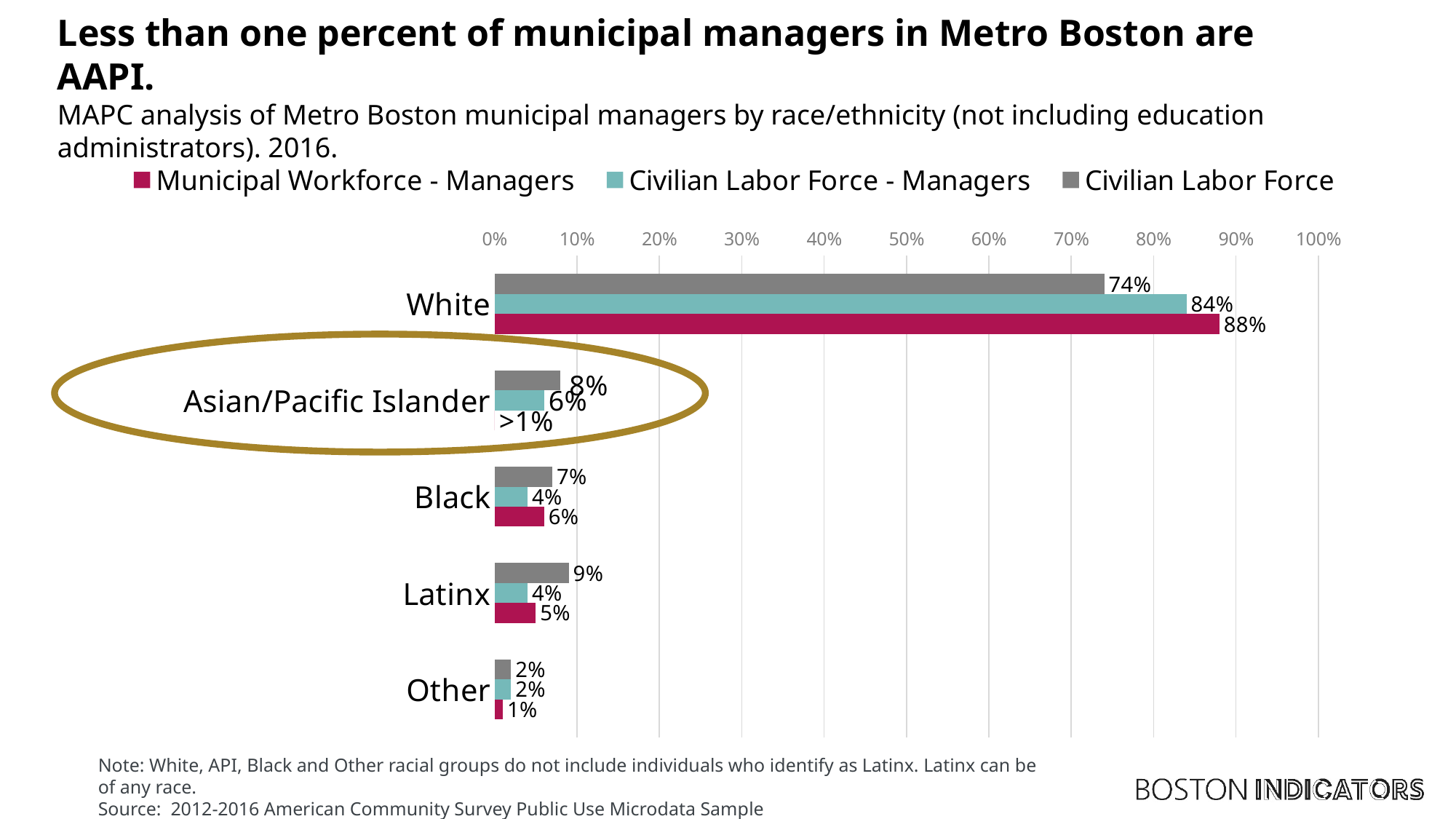
What is the Municipal Workforce - Managers value for White? 88% Which category is circled on the chart? Asian/Pacific Islander What is the Civilian Labor Force - Managers value for Asian/Pacific Islander? 6% How many race/ethnicity categories are shown on the chart? 5 Which category has the lowest Municipal Workforce - Managers value? Asian/Pacific Islander For Black, which is larger: the Municipal Workforce - Managers value or the Civilian Labor Force - Managers value? Municipal Workforce - Managers What kind of chart is shown on the slide? Bar chart What is the Civilian Labor Force value for Latinx? 9% Which category has the highest Civilian Labor Force value? White How many series does the legend list? 3 What is the difference between the Municipal Workforce - Managers value and the Civilian Labor Force value for White? 14% What label is printed for the Municipal Workforce - Managers bar for Asian/Pacific Islander? >1%